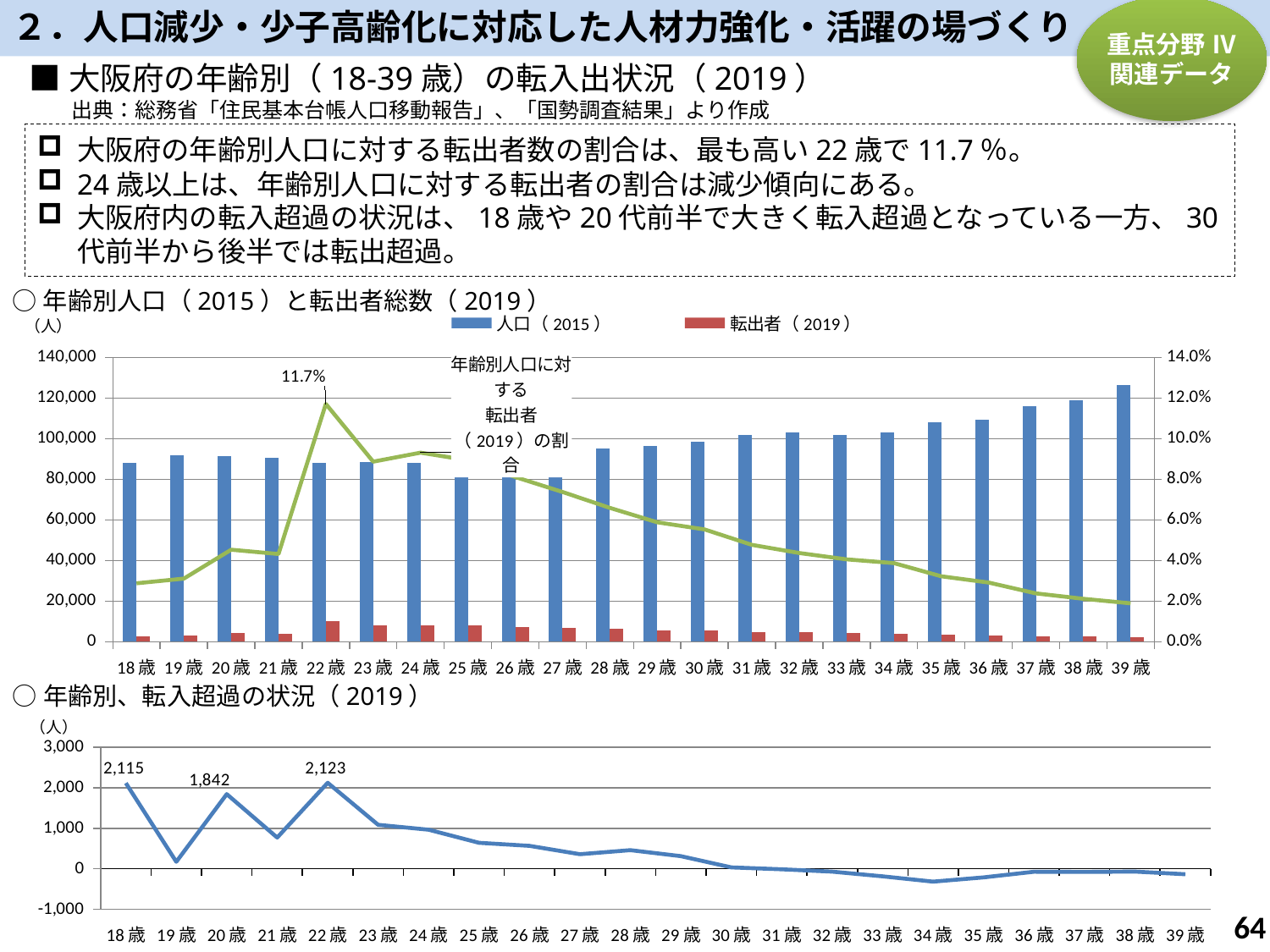
In the top chart (年齢別人口（2015）と転出者総数（2019）), at which age is the 転出者 ratio line highest? 22歳 In the top chart (年齢別人口（2015）と転出者総数（2019）), how many series does the legend list? 2 In the top chart (年齢別人口（2015）と転出者総数（2019）), what is the labelled ratio of 転出者 to population at 22歳? 11.7% In the top chart (年齢別人口（2015）と転出者総数（2019）), which age has the tallest 人口（2015） bar? 39歳 What kind of chart is the bottom chart (年齢別、転入超過の状況（2019）)? line chart In the top chart (年齢別人口（2015）と転出者総数（2019）), is the 人口（2015） value for 39歳 greater or less than 120,000? greater In the top chart (年齢別人口（2015）と転出者総数（2019）), how many age categories are shown on the x axis? 22 In the top chart (年齢別人口（2015）と転出者総数（2019）), does the green ratio line rise or fall from 24歳 to 39歳? fall In the bottom chart (年齢別、転入超過の状況（2019）), what is the value for 20歳? 1,842 In the top chart (年齢別人口（2015）と転出者総数（2019）), is the 人口（2015） value for 25歳 greater or less than 100,000? less In the bottom chart (年齢別、転入超過の状況（2019）), what is the difference between the values for 22歳 and 18歳? 8 In the bottom chart (年齢別、転入超過の状況（2019）), what is the value for 22歳? 2,123